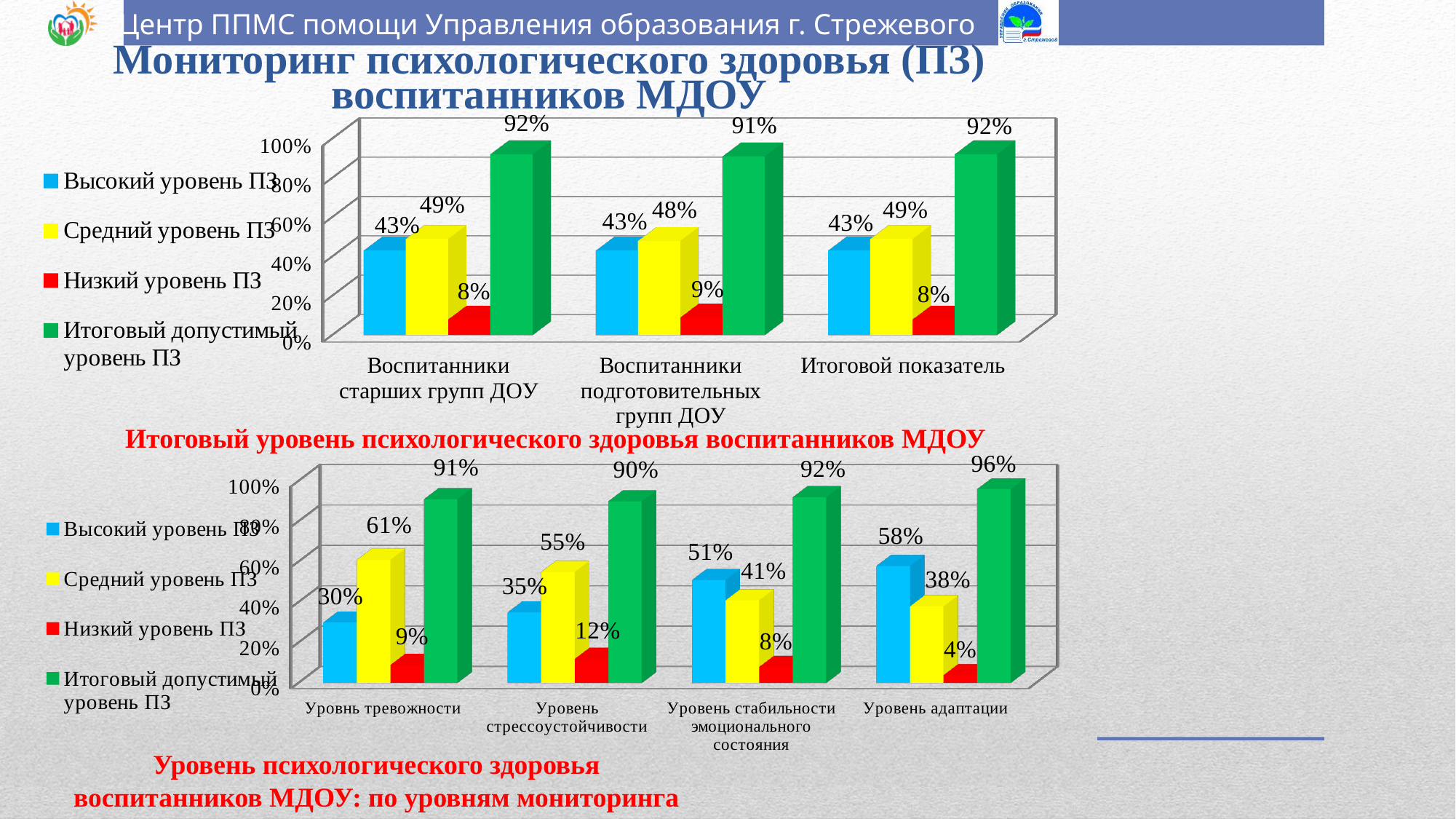
In the top chart, what is the value of Средний уровень ПЗ for Воспитанники подготовительных групп ДОУ? 48% In the bottom chart, which category has the lowest Низкий уровень ПЗ value? Уровень адаптации In the top chart, what is the difference between Средний уровень ПЗ and Высокий уровень ПЗ for Воспитанники старших групп ДОУ? 6% In the bottom chart, what is the value of Низкий уровень ПЗ for Уровень стрессоустойчивости? 12% In the bottom chart, what is the value of Высокий уровень ПЗ for Уровень адаптации? 58% In the top chart, how many series does the legend list? 4 In the bottom chart, which is larger for Уровень стабильности эмоционального состояния: Высокий уровень ПЗ or Средний уровень ПЗ? Высокий уровень ПЗ In the bottom chart, how many categories are shown on the x axis? 4 In the bottom chart, which category has the highest Итоговый допустимый уровень ПЗ value? Уровень адаптации In the top chart, what is the value of Низкий уровень ПЗ for Воспитанники старших групп ДОУ? 8% In the top chart, what is the Итоговый допустимый уровень ПЗ value for Итоговой показатель? 92% What type of chart is the bottom chart? Bar chart